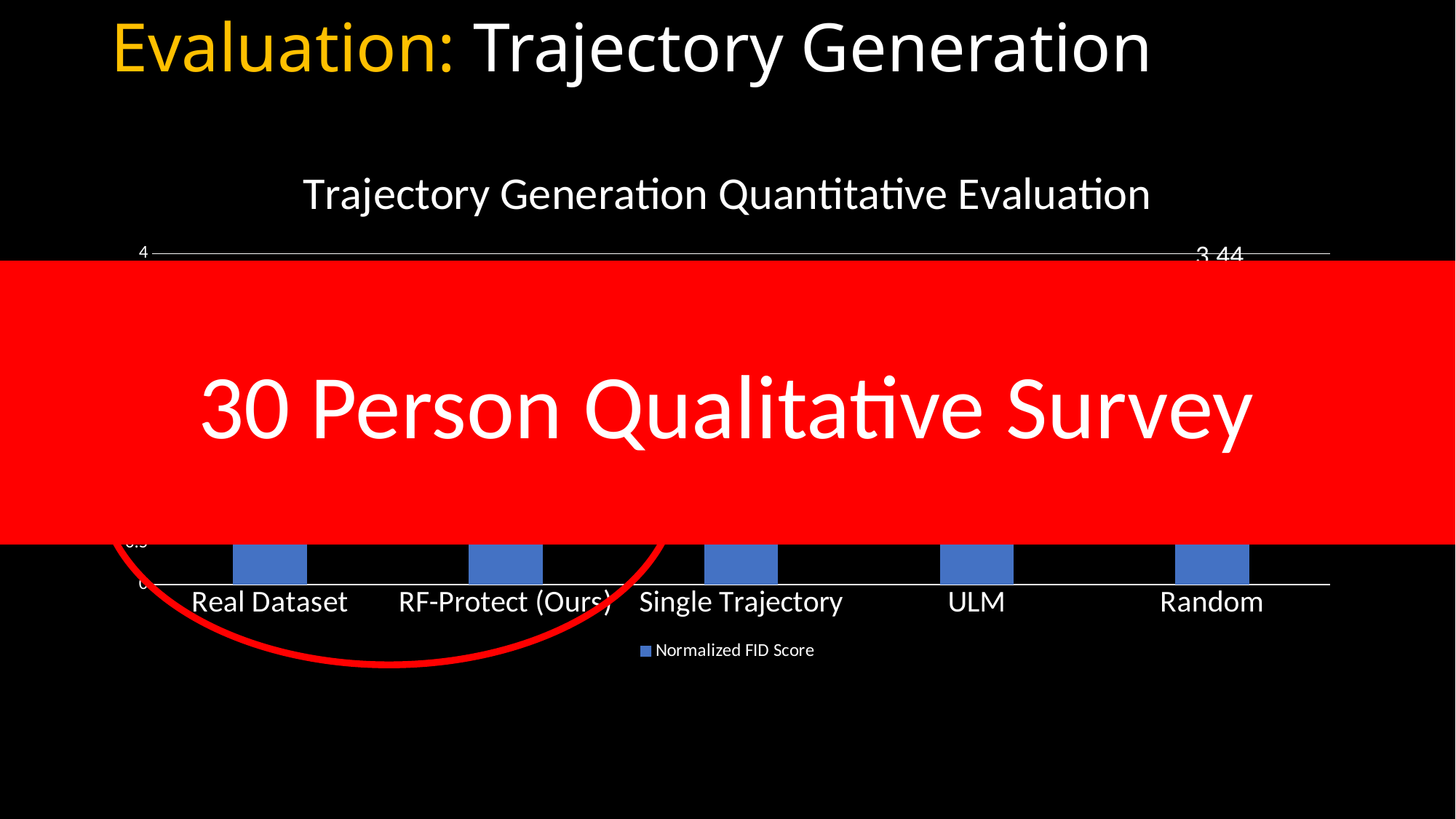
What is the title of the chart? Trajectory Generation Quantitative Evaluation How many series does the chart legend list? 1 Which category has the highest Normalized FID Score? Random How many categories are shown on the x axis of the chart? 5 What series name is shown in the chart legend? Normalized FID Score What is the Normalized FID Score for Random? 3.44 Is the value for Random greater or less than 0.5? greater What kind of chart is shown on the slide? bar chart